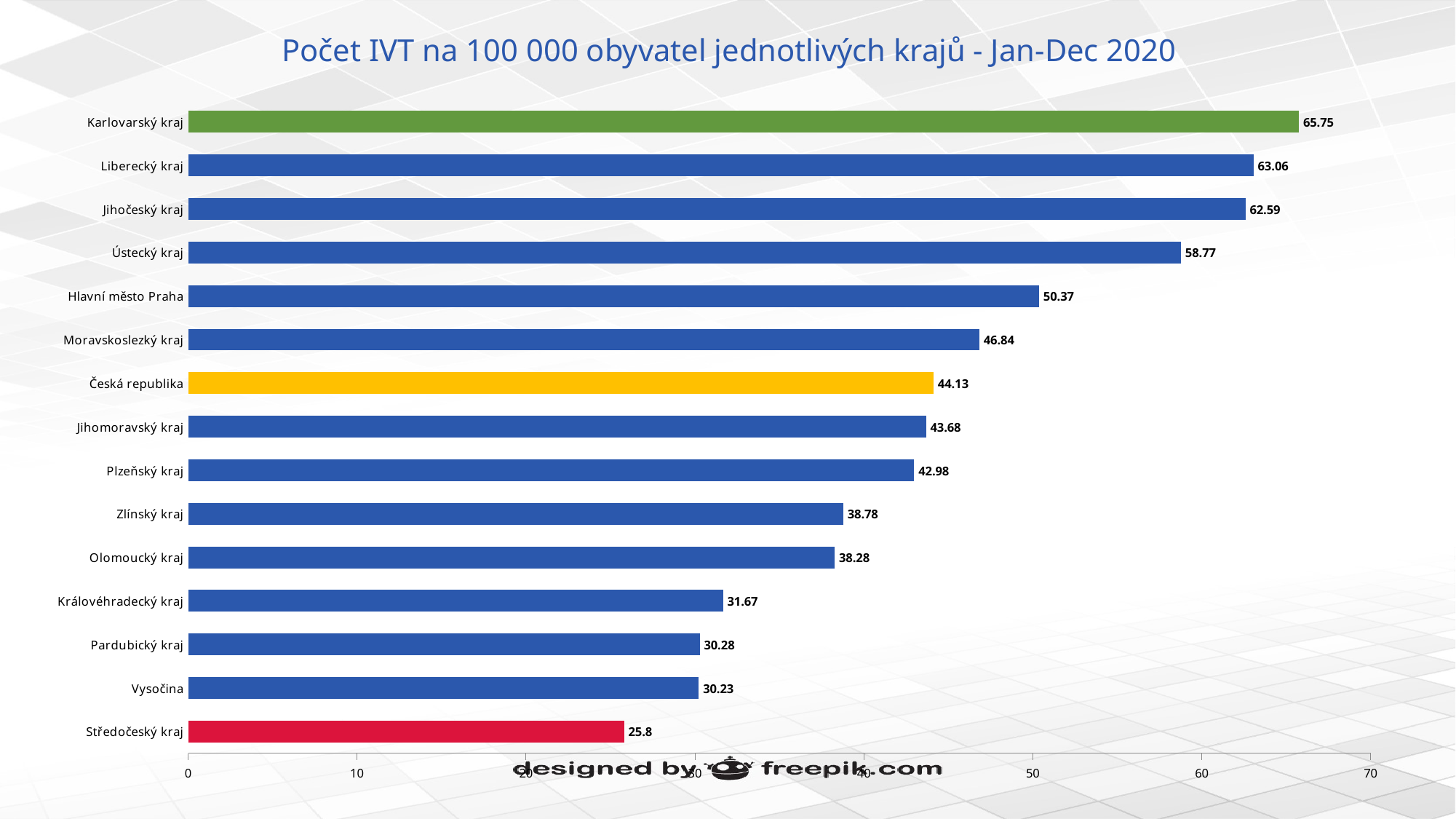
What is the title of the chart? Počet IVT na 100 000 obyvatel jednotlivých krajů - Jan-Dec 2020 What is the difference between the values for Karlovarský kraj and Středočeský kraj? 39.95 Which category has the highest value? Karlovarský kraj How many categories are shown in the chart? 15 What is the value for Hlavní město Praha? 50.37 Which category has the lowest value? Středočeský kraj What is the value for Česká republika? 44.13 Which is larger, the value for Ústecký kraj or the value for Moravskoslezký kraj? Ústecký kraj What is the difference between the values for Liberecký kraj and Jihočeský kraj? 0.47 What is the value for Karlovarský kraj? 65.75 What kind of chart is shown on the slide? bar chart Is the value for Zlínský kraj greater or less than 40? less